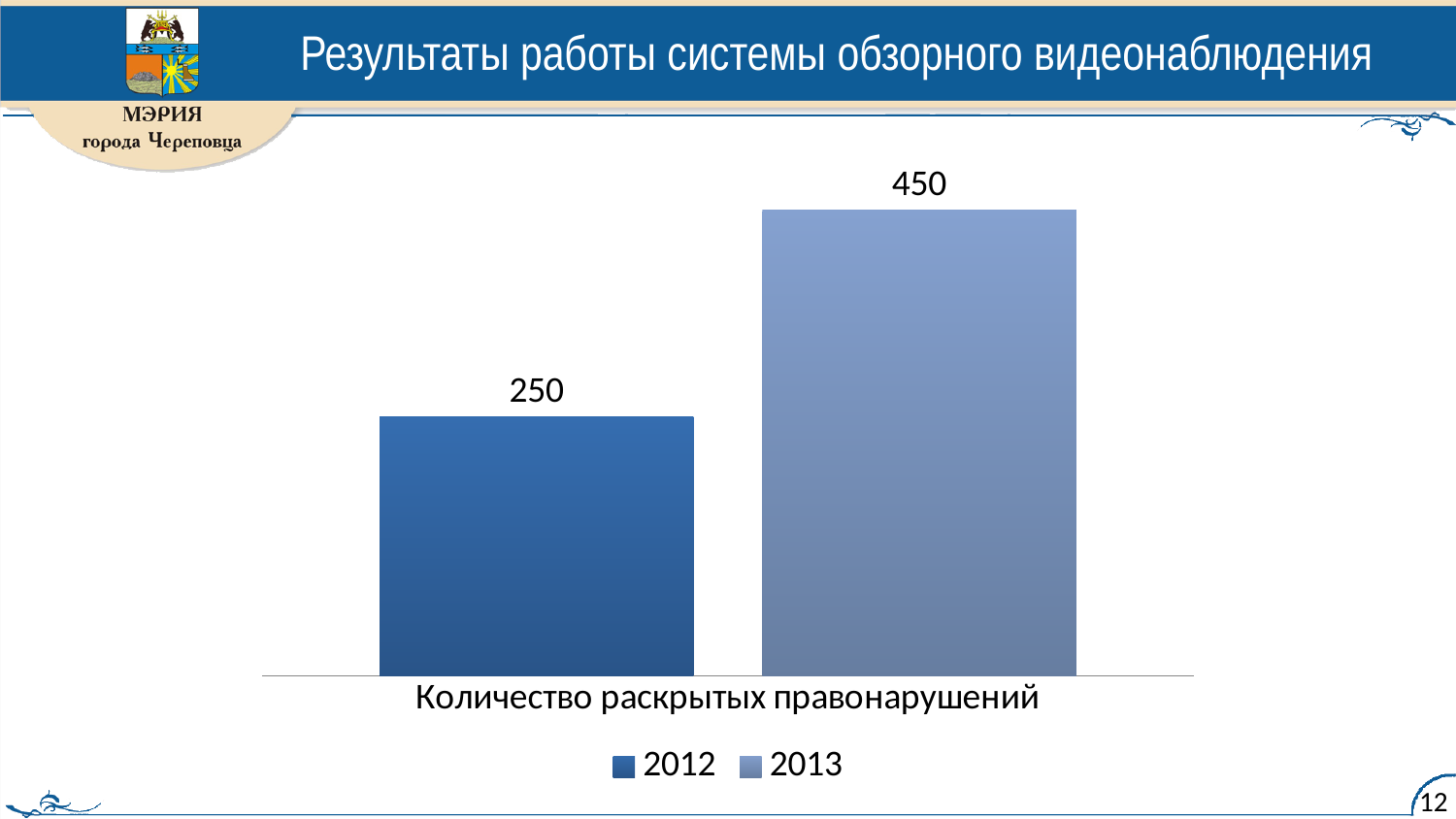
How many bars are plotted in the chart? 2 What is the difference between the 2013 and 2012 values? 200 How many series does the legend list? 2 Did the number of solved offences rise or fall from 2012 to 2013? rise What kind of chart is shown on the slide? bar chart What is the value for 2012 in the chart? 250 Which series has the higher value, 2012 or 2013? 2013 What is the title of the slide containing the chart? Результаты работы системы обзорного видеонаблюдения Which series has the lower value in the chart? 2012 What is the value for 2013 in the chart? 450 Is the value for 2012 larger or smaller than the value for 2013? smaller What is the category label shown under the bars? Количество раскрытых правонарушений